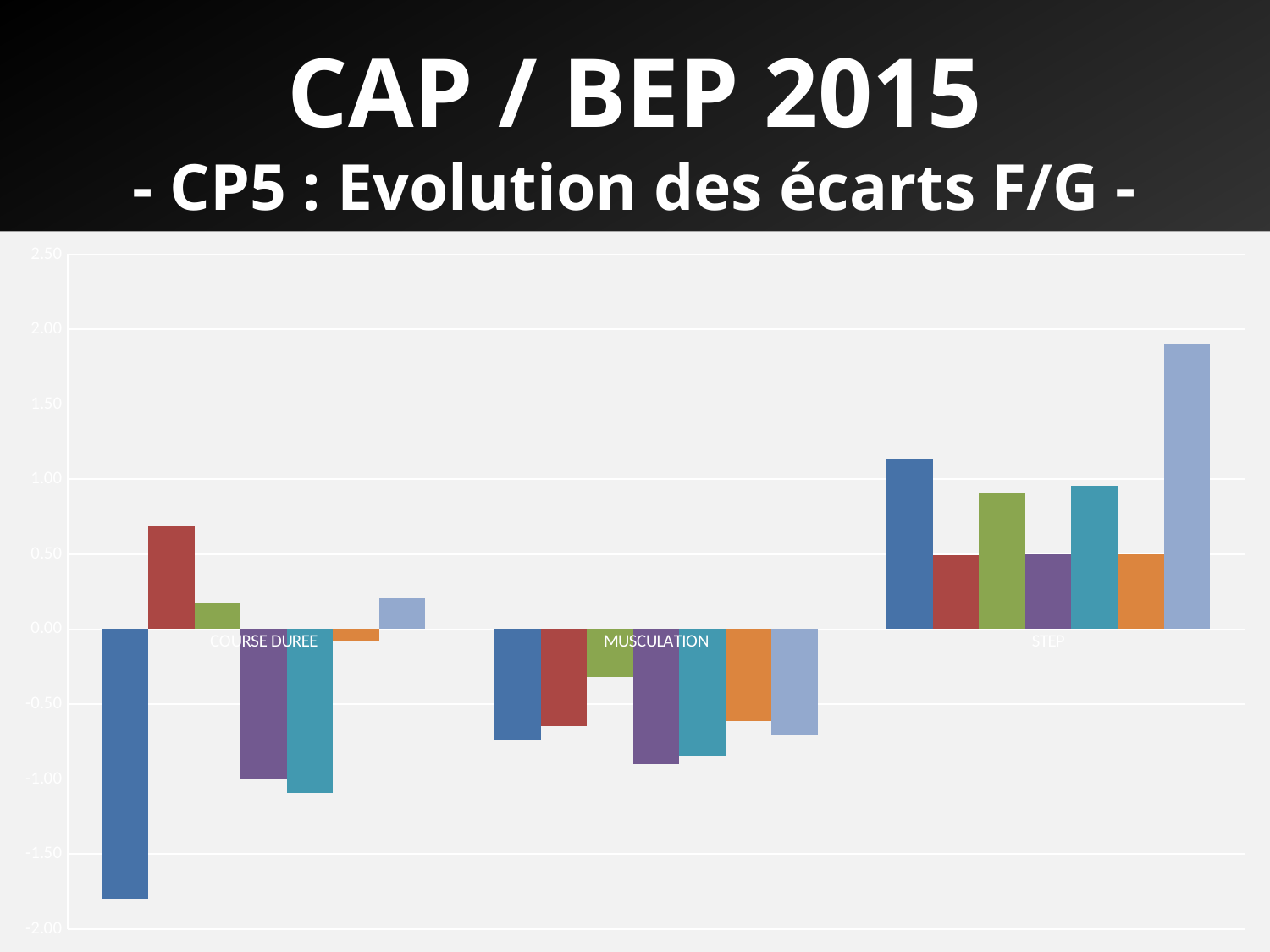
Is the value of the first (dark blue) bar in the MUSCULATION category greater or less than -0.50? less Is the value of the first (dark blue) bar in the COURSE DUREE category greater or less than -1.50? less How many bars are plotted for the STEP category? 7 How many categories are shown on the x axis of the chart? 3 What kind of chart is shown on the slide? bar chart Which category contains the highest bar on the chart? STEP In the STEP category, which is larger: the first (dark blue) bar or the third (green) bar? the first (dark blue) bar Which category contains the lowest bar on the chart? COURSE DUREE Is the value of the tallest bar in the STEP category greater or less than 1.50? greater What is the subtitle of the slide above the chart? - CP5 : Evolution des écarts F/G - Which category has all of its bars below 0.00? MUSCULATION